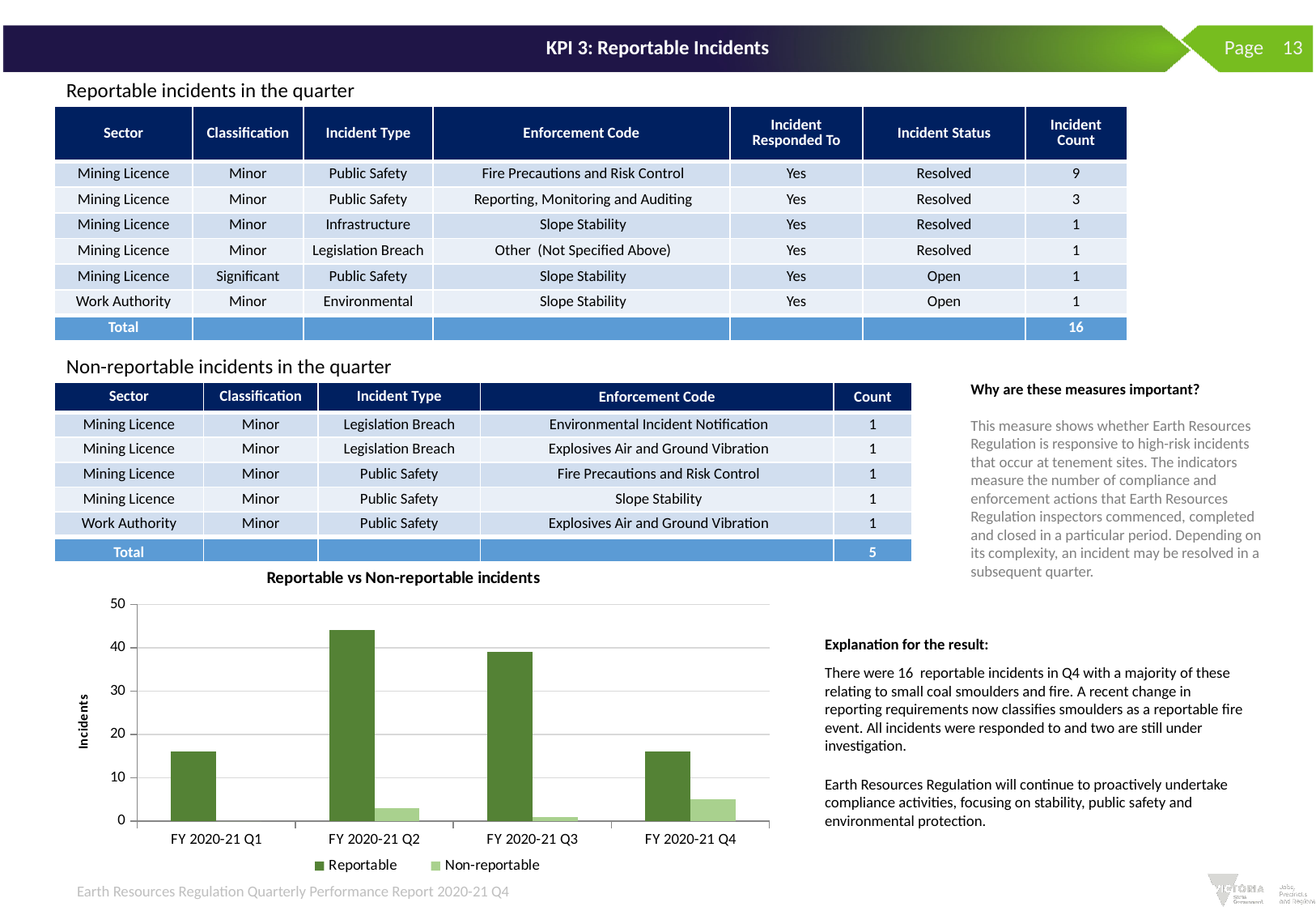
Is the Non-reportable value for FY 2020-21 Q4 greater or less than 10? less How many series does the chart's legend list? 2 Is the Reportable value for FY 2020-21 Q2 greater or less than 40? greater Which quarter has the highest Reportable incidents bar? FY 2020-21 Q2 Do Reportable incidents rise or fall from FY 2020-21 Q3 to FY 2020-21 Q4? fall How many quarters are shown on the x axis of the chart? 4 What kind of chart is shown on the slide? Bar chart Which is larger, the Reportable value for FY 2020-21 Q2 or for FY 2020-21 Q3? FY 2020-21 Q2 Which quarter has the highest Non-reportable incidents bar? FY 2020-21 Q4 What is the title of the chart? Reportable vs Non-reportable incidents Which quarter has the lowest Non-reportable incidents value? FY 2020-21 Q1